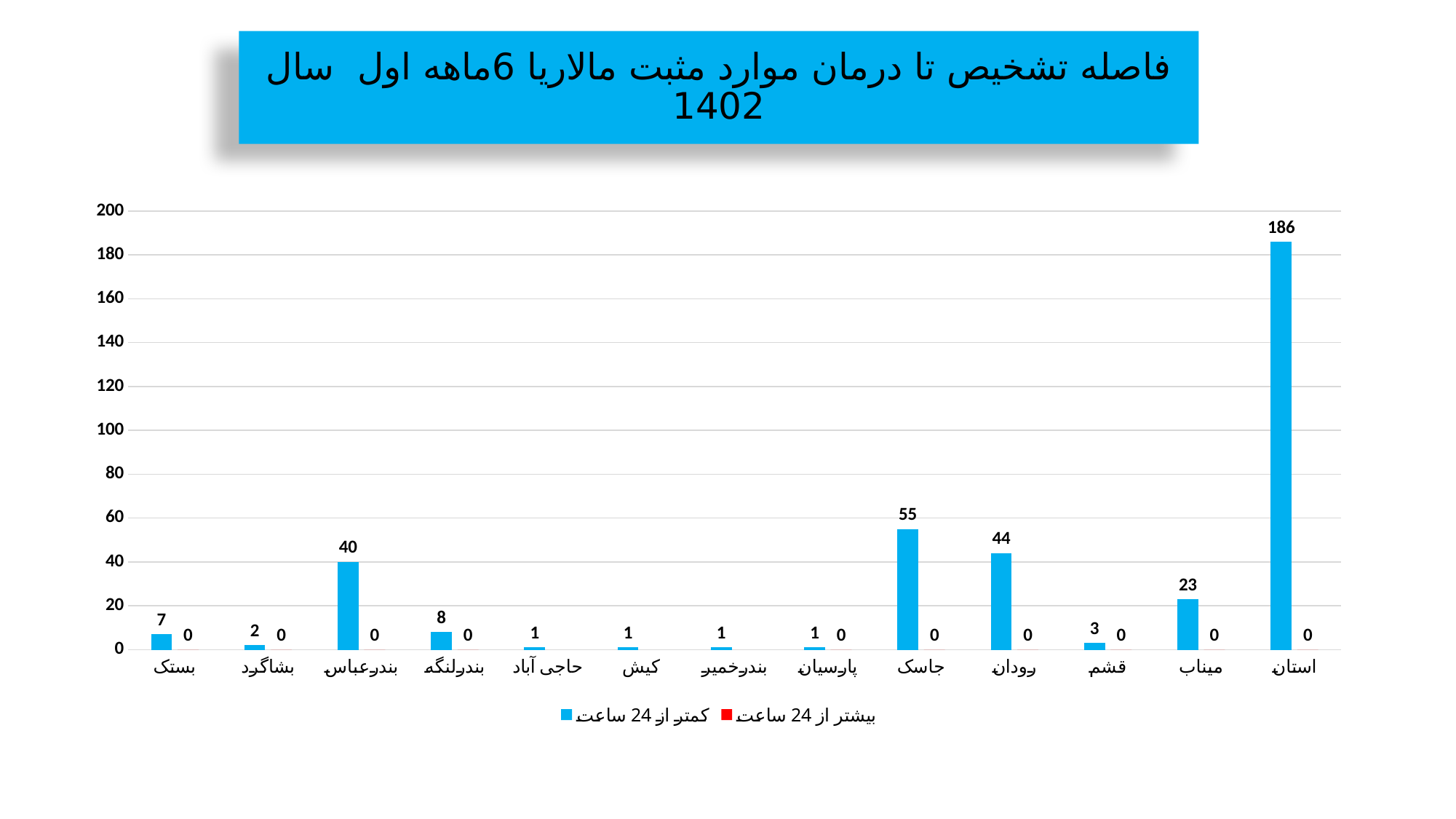
What is the value of the blue bar for رودان? 44 What is the value of the blue bar for جاسک? 55 How many categories are shown along the x axis of the chart? 13 What kind of chart is shown on the slide? bar chart What is the title of the chart? فاصله تشخیص تا درمان موارد مثبت مالاریا 6ماهه اول سال 1402 How many series does the chart's legend list? 2 Is the blue bar value for استان greater or less than 180? greater Which has a larger blue bar value, بندرعباس or میناب? بندرعباس Which category has the highest blue bar? استان What is the value of the blue bar for استان? 186 What is the difference between the blue bar values for جاسک and رودان? 11 What is the value of the blue bar for بستک? 7